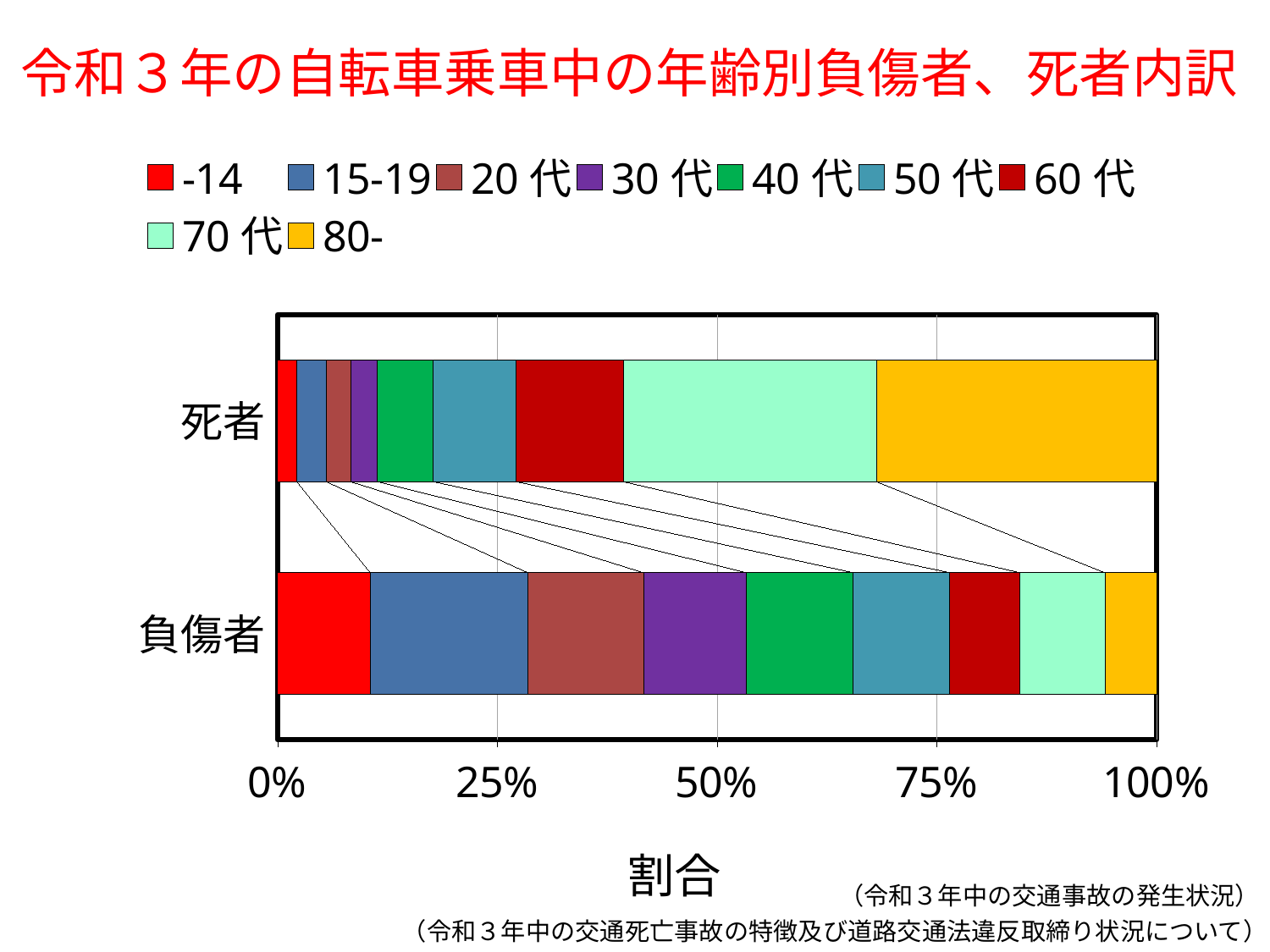
What is the label of the horizontal axis? 割合 Is the share of 80- larger in the 死者 bar or the 負傷者 bar? 死者 Which age group takes the largest share of the 死者 bar? 80- Which age group takes the largest share of the 負傷者 bar? 15-19 How many categories (bars) does the chart show? 2 How many series does the legend list? 9 What is the title of the chart on the slide? 令和３年の自転車乗車中の年齢別負傷者、死者内訳 Is the share of -14 in the 負傷者 bar greater or less than 25%? less What kind of chart is shown on the slide? stacked bar chart Is the share of -14 larger in the 死者 bar or the 負傷者 bar? 負傷者 Which age group takes the smallest share of the 負傷者 bar? 80- Is the share of 80- in the 死者 bar greater or less than 25%? greater